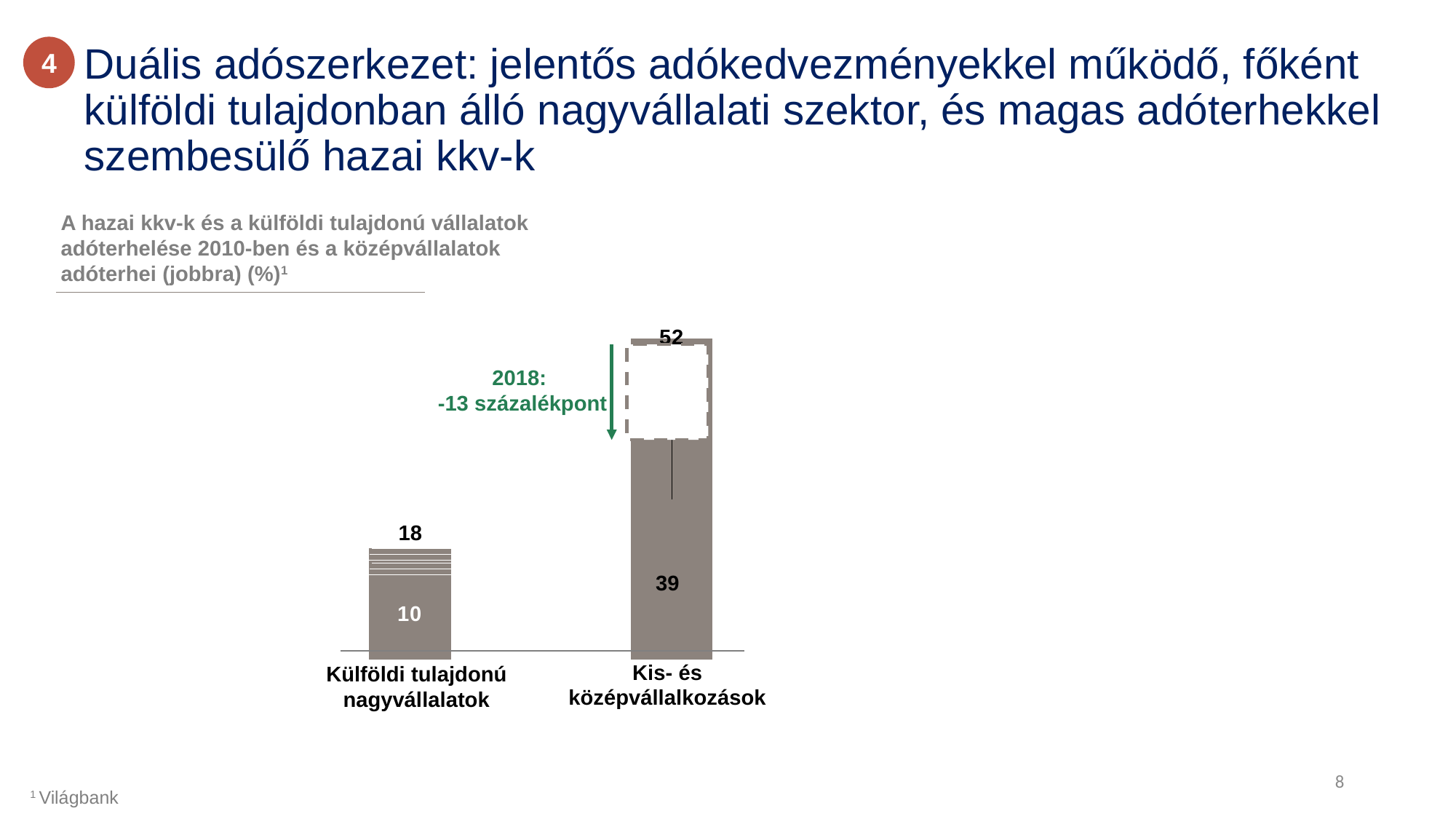
Which category has the lowest tax burden in the chart? Külföldi tulajdonú nagyvállalatok What kind of chart is shown on the slide? bar chart What is the difference between the 2010 value (52) and the 2018 value (39) for Kis- és középvállalkozások? 13 What source is cited in the footnote for the chart? Világbank What is the 2010 tax burden value shown at the top of the bar for Kis- és középvállalkozások? 52 What is the 2010 tax burden value shown for Külföldi tulajdonú nagyvállalatok? 18 How many categories are shown on the x axis of the chart? 2 Which category has the higher 2010 tax burden, Külföldi tulajdonú nagyvállalatok or Kis- és középvállalkozások? Kis- és középvállalkozások What change is indicated by the green arrow for 2018? -13 százalékpont What is the difference between the 2010 values for Kis- és középvállalkozások (52) and Külföldi tulajdonú nagyvállalatok (18)? 34 What value is printed inside the lower part of the Külföldi tulajdonú nagyvállalatok bar? 10 What value is shown for Kis- és középvállalkozások in 2018? 39